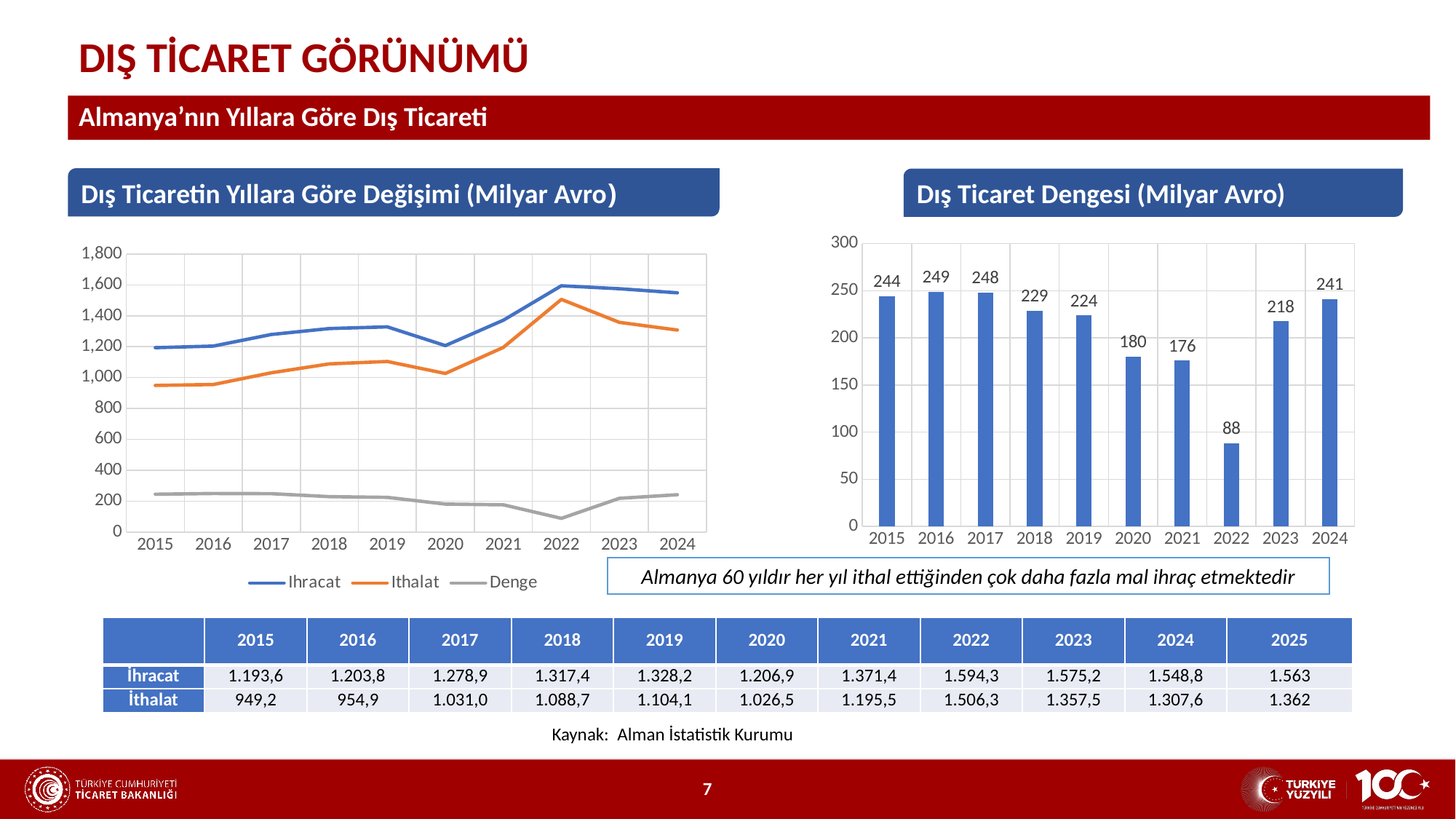
In the 'Dış Ticaretin Yıllara Göre Değişimi (Milyar Avro)' chart, is the Ihracat value for 2022 greater or less than 1,400? greater In the 'Dış Ticaret Dengesi (Milyar Avro)' chart, what is the value for 2022? 88 In the 'Dış Ticaret Dengesi (Milyar Avro)' chart, which year has the larger value, 2018 or 2019? 2018 How many series does the legend of the 'Dış Ticaretin Yıllara Göre Değişimi (Milyar Avro)' chart list? 3 What kind of chart is the 'Dış Ticaretin Yıllara Göre Değişimi (Milyar Avro)' chart? line chart In the 'Dış Ticaret Dengesi (Milyar Avro)' chart, which year has the lowest value? 2022 In the 'Dış Ticaret Dengesi (Milyar Avro)' chart, which year has the highest value? 2016 How many bars are shown in the 'Dış Ticaret Dengesi (Milyar Avro)' chart? 10 What kind of chart is the 'Dış Ticaret Dengesi (Milyar Avro)' chart? bar chart In the 'Dış Ticaret Dengesi (Milyar Avro)' chart, what is the value for 2020? 180 In the 'Dış Ticaretin Yıllara Göre Değişimi (Milyar Avro)' chart, is the Ithalat value for 2015 greater or less than 1,000? less In the 'Dış Ticaret Dengesi (Milyar Avro)' chart, what is the difference between the values for 2024 and 2023? 23